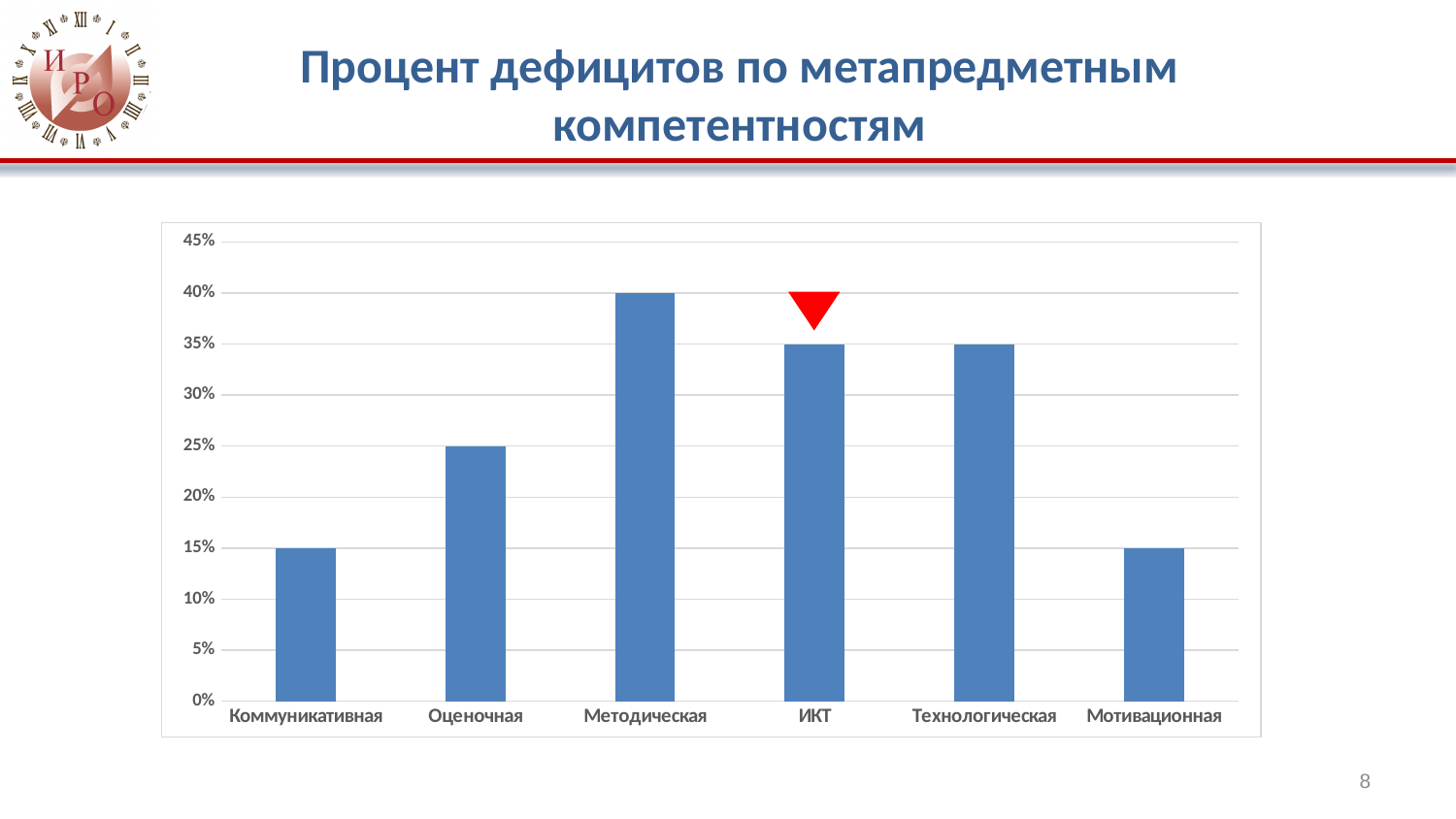
What is the value for Оценочная? 25% What is the title of the slide containing the chart? Процент дефицитов по метапредметным компетентностям What is the value for Методическая? 40% Above which category's bar is a red triangle marker placed? ИКТ What is the value for Коммуникативная? 15% Which category has the highest value? Методическая What type of chart is shown on the slide? Bar chart Which is larger, the value for Методическая or the value for Технологическая? Методическая Is the value for Мотивационная greater or less than 20%? less What is the value for ИКТ? 35% What is the difference between the values for Методическая and Оценочная? 15% How many categories are shown on the x axis of the chart? 6